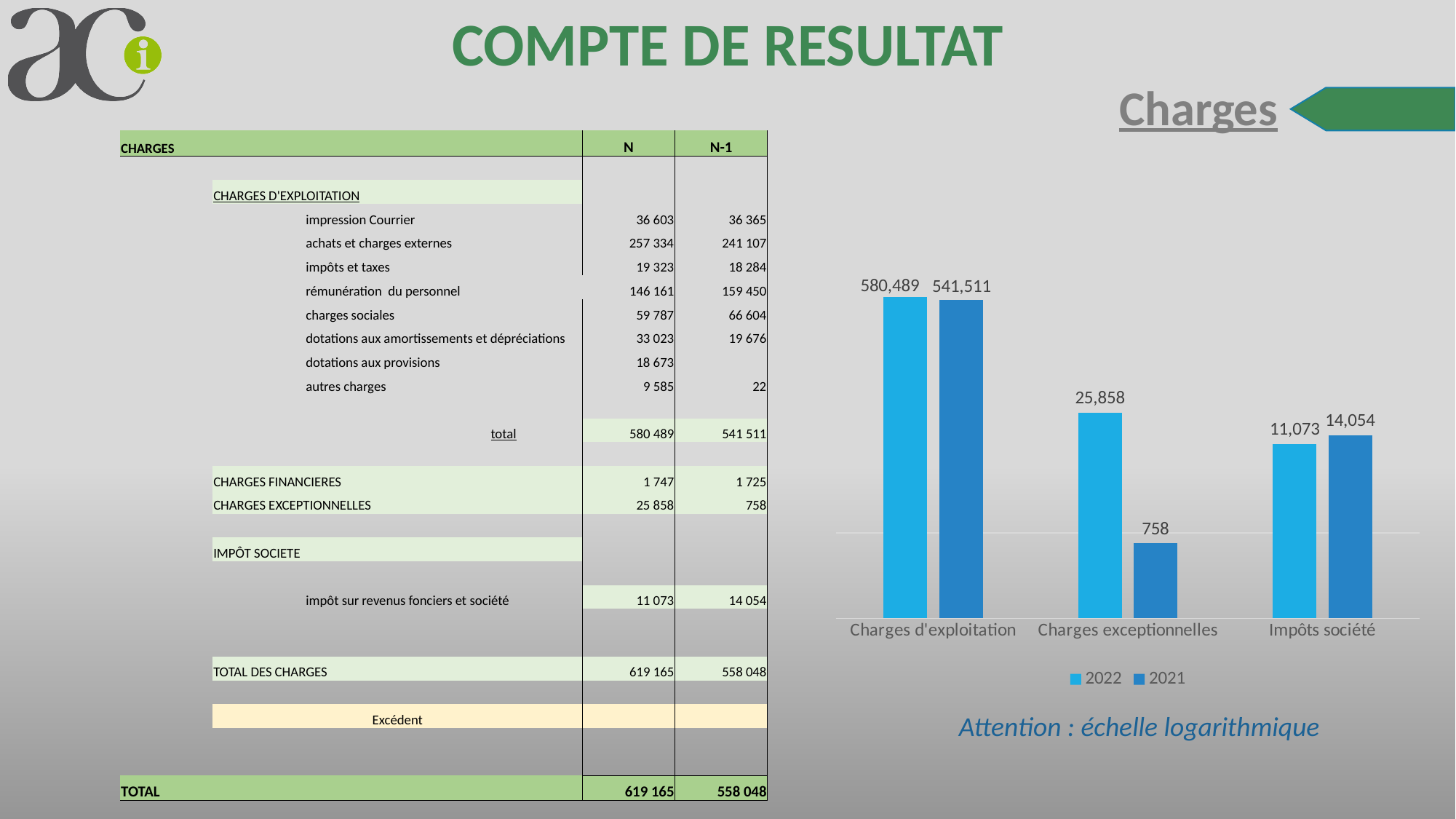
Which category has the highest value for 2022? Charges d'exploitation What is the difference between the 2021 and 2022 values for Impôts société? 2,981 How many categories are shown on the x axis of the chart? 3 What is the value for Charges d'exploitation in 2021? 541,511 How many series does the chart legend list? 2 Which category has the lowest value for 2021? Charges exceptionnelles What is the value for Charges exceptionnelles in 2021? 758 What kind of chart is shown on the slide? Bar chart For Impôts société, which year has the larger value, 2022 or 2021? 2021 What is the value for Impôts société in 2022? 11,073 What is the difference between the 2022 and 2021 values for Charges exceptionnelles? 25,100 What is the value for Charges d'exploitation in 2022? 580,489